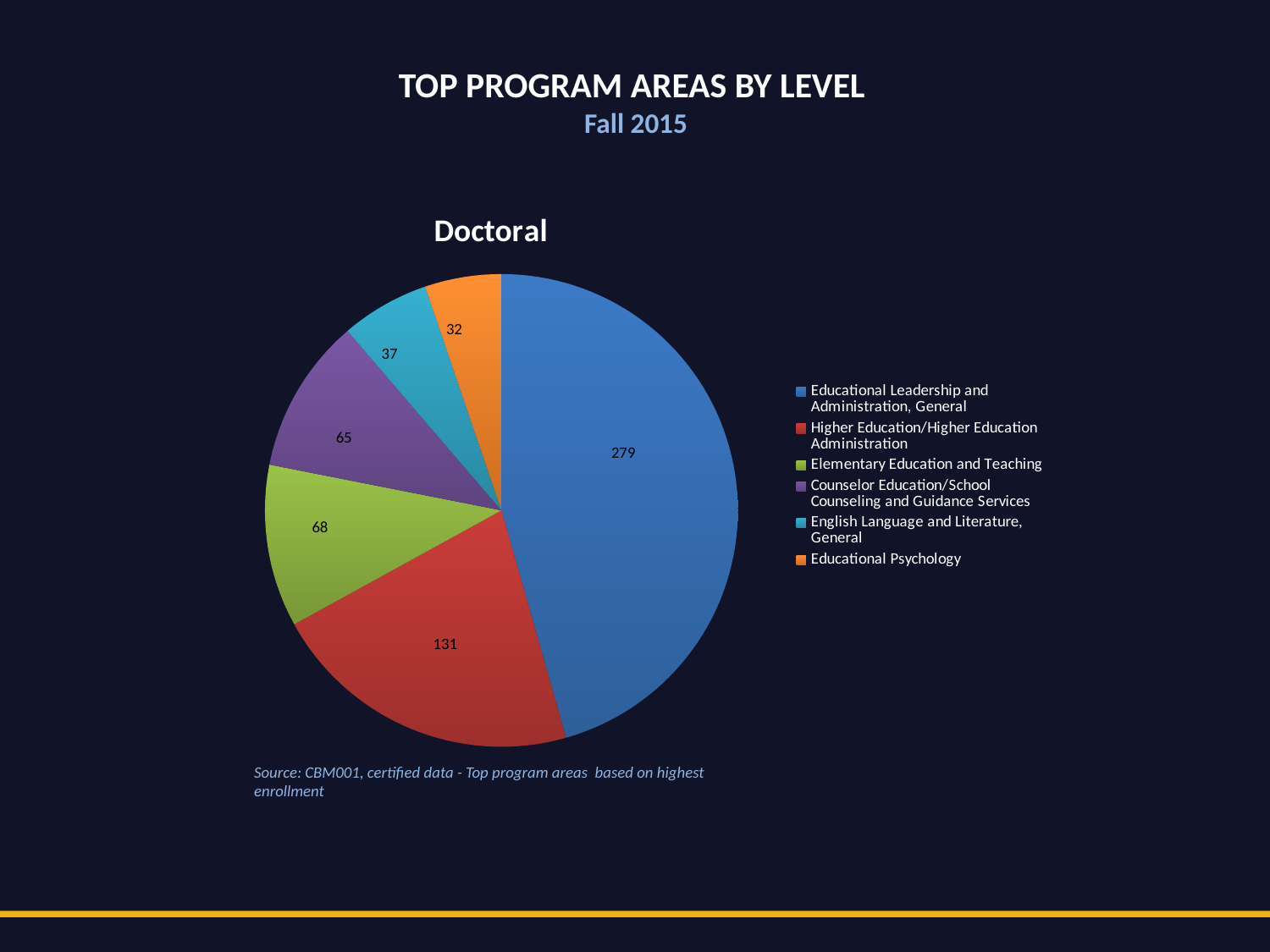
What is the title of the chart? Doctoral What type of chart is shown on the slide? pie chart What is the value for Higher Education/Higher Education Administration? 131 What is the total of all slices in the pie chart? 612 Which program area has the smallest slice? Educational Psychology What is the value for Educational Psychology? 32 How many slices does the pie chart have? 6 How many entries does the legend list? 6 What is the value for Educational Leadership and Administration, General? 279 Which is larger: Elementary Education and Teaching or English Language and Literature, General? Elementary Education and Teaching Which program area has the largest slice? Educational Leadership and Administration, General What is the difference between Educational Leadership and Administration, General and Higher Education/Higher Education Administration? 148